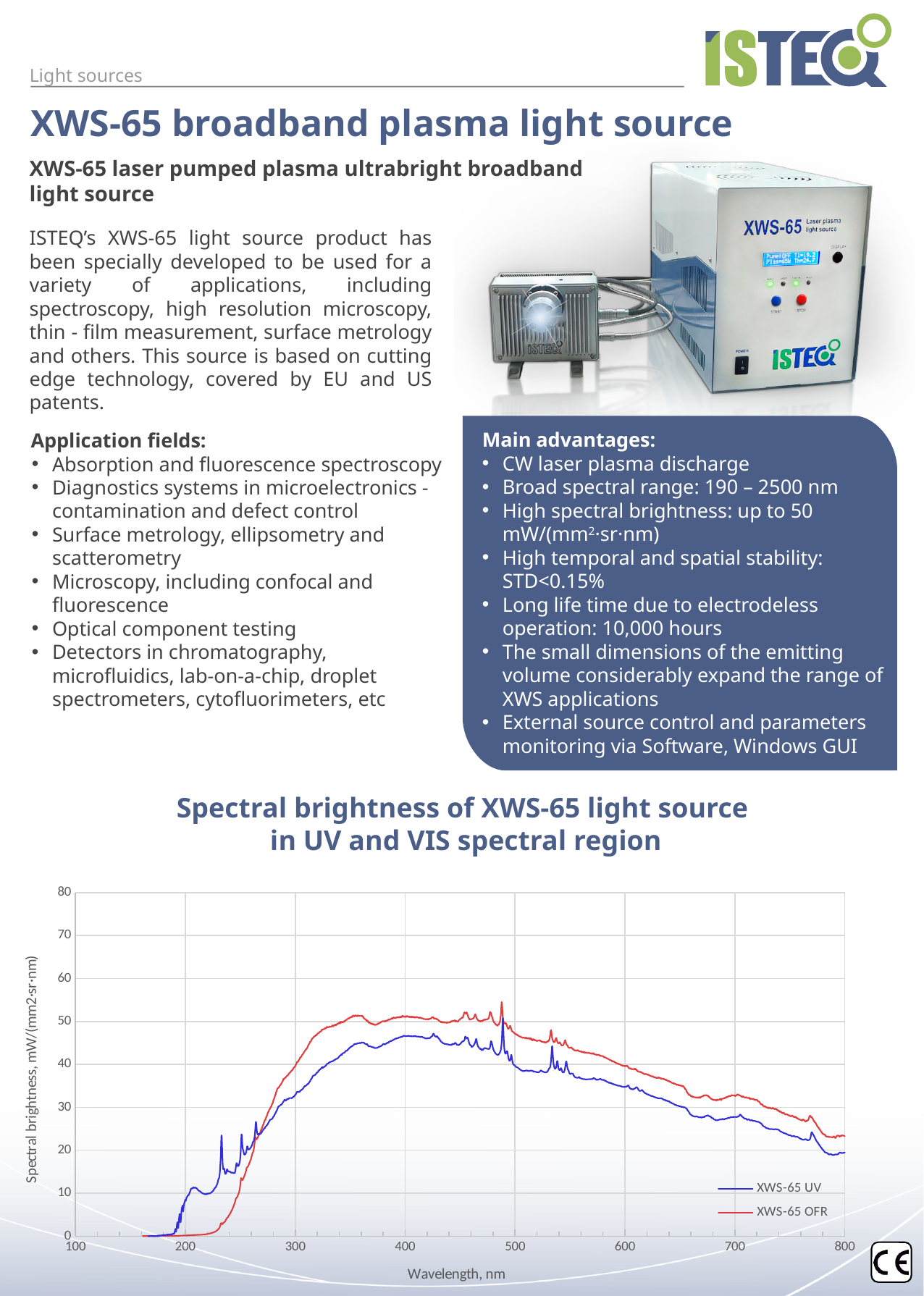
In the spectral brightness chart, do the values of the XWS-65 OFR series rise or fall between 500 nm and 800 nm? fall In the spectral brightness chart, do the values of the XWS-65 UV series rise or fall between 200 nm and 350 nm? rise In the spectral brightness chart, is the value of the XWS-65 OFR series at 700 nm greater or less than 30? greater In the spectral brightness chart, is the value of the XWS-65 UV series at 700 nm greater or less than 30? less What is the label of the x axis of the spectral brightness chart? Wavelength, nm How many series does the legend of the spectral brightness chart list? 2 What kind of chart is shown under the title "Spectral brightness of XWS-65 light source in UV and VIS spectral region"? line chart In the spectral brightness chart, is the value of the XWS-65 OFR series at 400 nm greater or less than 40? greater What are the two series named in the legend of the spectral brightness chart? XWS-65 UV and XWS-65 OFR In the spectral brightness chart, which series has the higher value at 600 nm, XWS-65 UV or XWS-65 OFR? XWS-65 OFR